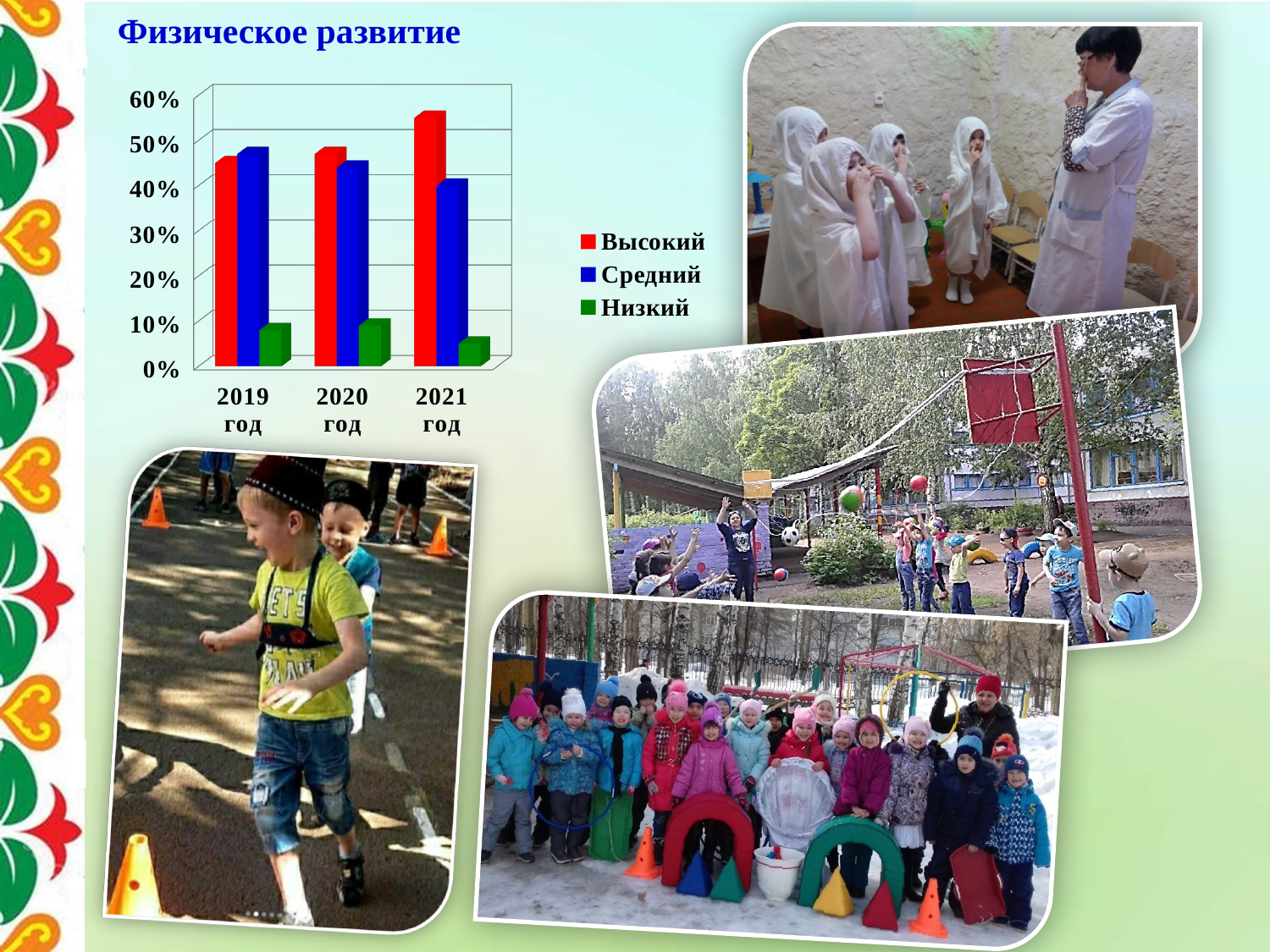
Is the value for Высокий in 2021 год greater or less than 50%? greater How many year categories are shown on the x axis of the chart? 3 In which year is the value for Высокий the highest? 2021 год Is the value for Высокий in 2019 год greater or less than 50%? less Which colour represents the series Низкий in the chart? green What kind of chart is shown on the slide? bar chart Is the value for Низкий in 2021 год greater or less than 10%? less Does the value for Высокий rise or fall from 2019 год to 2021 год? rise How many series does the chart legend list? 3 In which year is the value for Низкий the lowest? 2021 год In 2021 год, which is larger: Высокий or Средний? Высокий What is the title of the chart? Физическое развитие